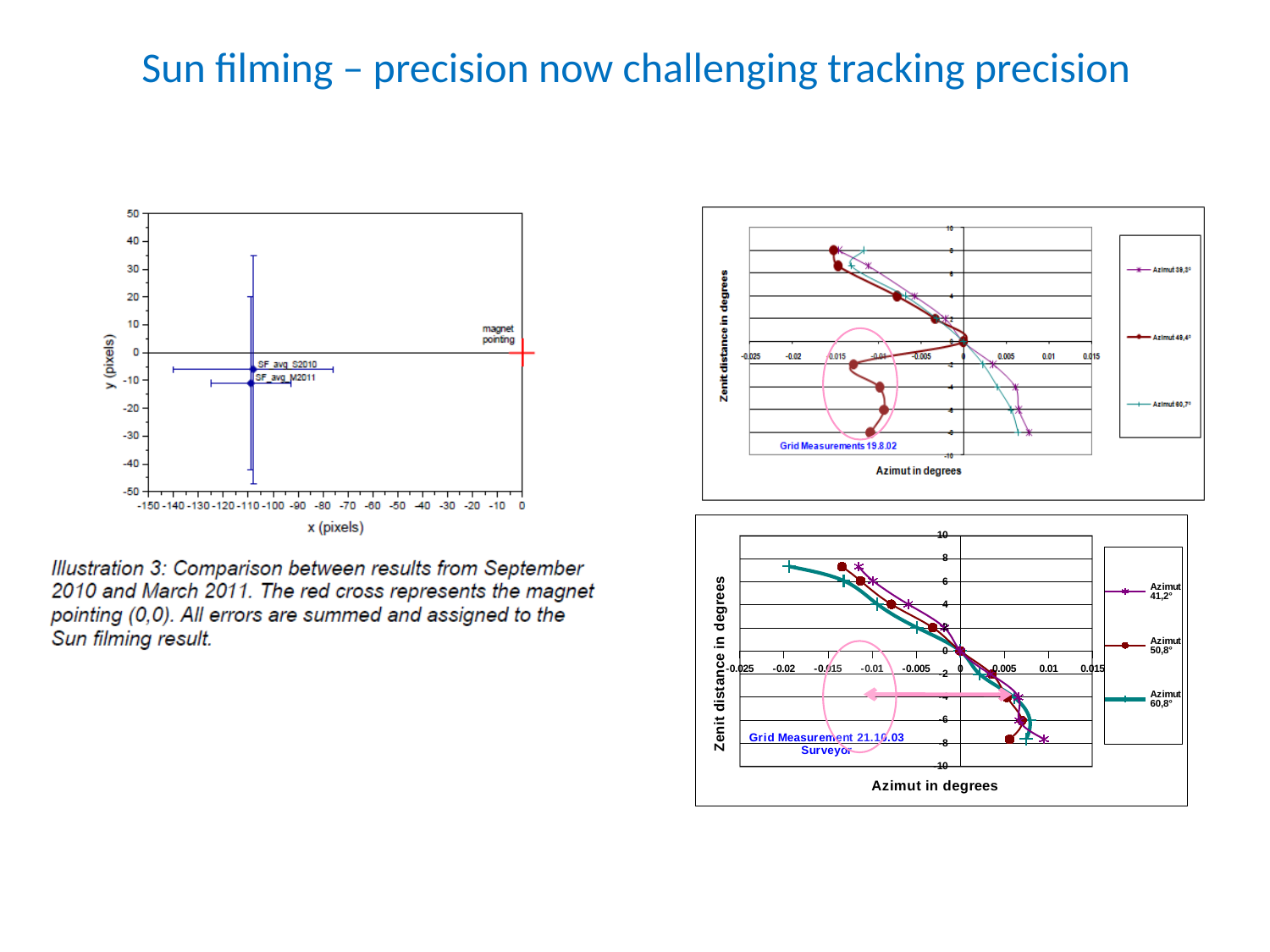
In the bottom-right chart (Grid Measurement 21.10.03 Surveyor), is the azimut value of the Azimut 60,8° series at zenit distance 8 greater or less than -0.01? less In the top-right chart (Grid Measurements 19.8.02), how many series does the legend list? 3 In the left chart (Illustration 3), what does the red cross represent? magnet pointing In the bottom-right chart (Grid Measurement 21.10.03 Surveyor), is the azimut value of the Azimut 41,2° series at zenit distance -8 greater or less than 0.005? greater What kind of chart is the left chart (Illustration 3)? scatter plot In the bottom-right chart (Grid Measurement 21.10.03 Surveyor), do the azimut values of the Azimut 60,8° series increase or decrease as the zenit distance goes from 8 down to -8? increase In the top-right chart (Grid Measurements 19.8.02), is the azimut value of the Azimut 60,7° series at zenit distance -8 greater or less than 0? greater In the top-right chart (Grid Measurements 19.8.02), which series is drawn with the thick dark red line? Azimut 49,4° In the bottom-right chart (Grid Measurement 21.10.03 Surveyor), how many series does the legend list? 3 In the left chart (Illustration 3), how many labeled Sun filming measurement points are plotted? 2